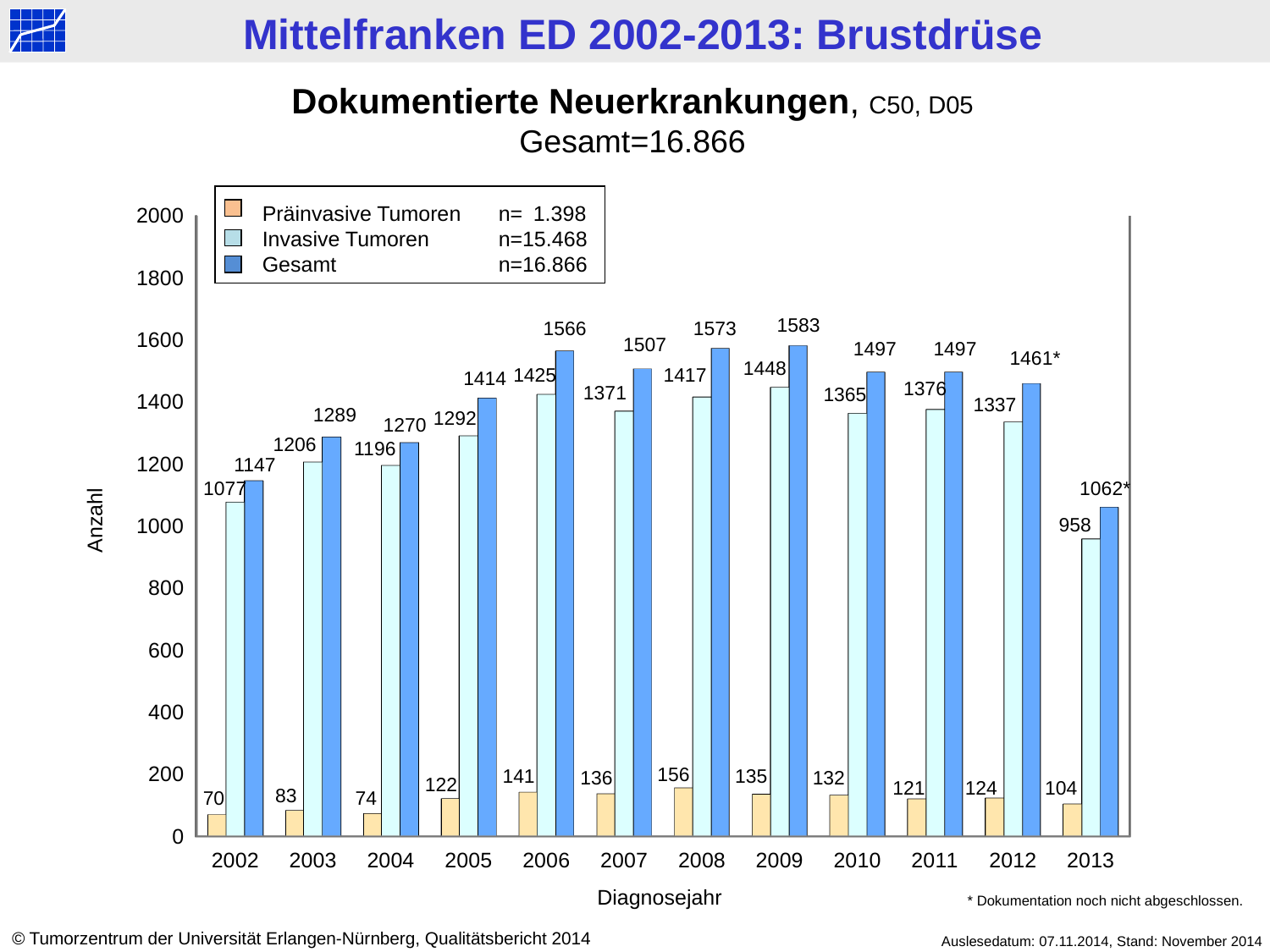
What is the value for Gesamt in 2009? 1583 Which is larger, the Invasive Tumoren value for 2010 or for 2011? 2011 Which year has the lowest Präinvasive Tumoren value? 2002 What is the value for Präinvasive Tumoren in 2008? 156 Is the Gesamt value for 2013 greater or less than 1200? less What is the total n for Invasive Tumoren given in the legend? n=15.468 Which year has the highest Gesamt value? 2009 How many years are shown on the x axis? 12 What is the difference between the Gesamt values for 2008 and 2007? 66 What is the value for Invasive Tumoren in 2006? 1425 What kind of chart is shown on the slide? bar chart How many series does the legend list? 3